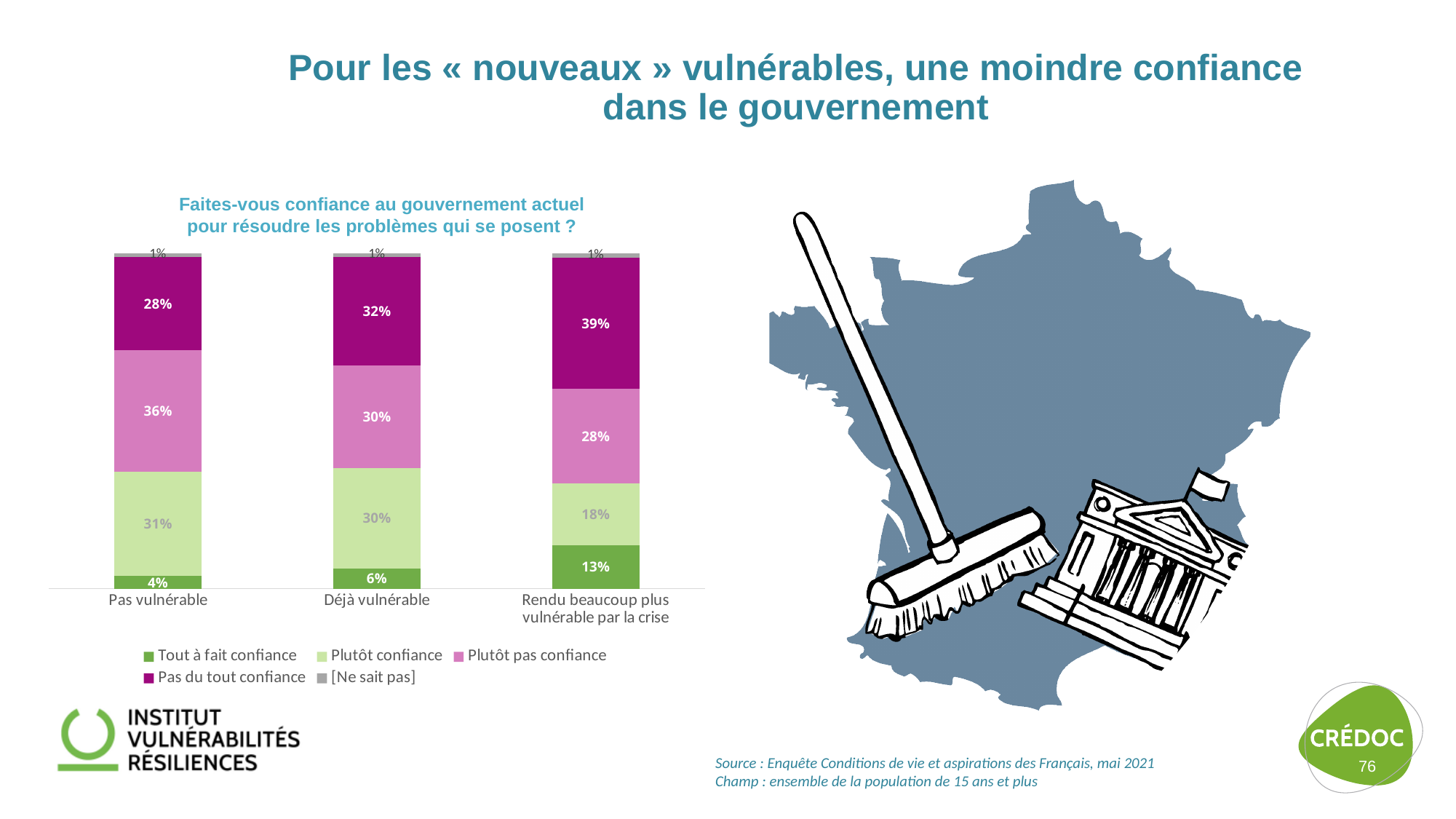
What is the value of 'Plutôt confiance' for 'Rendu beaucoup plus vulnérable par la crise'? 18% Which category has the highest value for 'Pas du tout confiance'? Rendu beaucoup plus vulnérable par la crise What kind of chart is shown on the slide? Stacked bar chart How many series does the legend list? 5 What is the value of 'Tout à fait confiance' for 'Pas vulnérable'? 4% What question is shown as the title of the chart? Faites-vous confiance au gouvernement actuel pour résoudre les problèmes qui se posent ? What is the difference between the 'Pas du tout confiance' values for 'Rendu beaucoup plus vulnérable par la crise' and 'Pas vulnérable'? 11% Which is larger: 'Plutôt confiance' for 'Pas vulnérable' or 'Plutôt confiance' for 'Rendu beaucoup plus vulnérable par la crise'? Pas vulnérable How many categories are shown on the x axis? 3 Which category has the lowest value for 'Tout à fait confiance'? Pas vulnérable What is the value of 'Pas du tout confiance' for 'Rendu beaucoup plus vulnérable par la crise'? 39% What is the value of 'Plutôt pas confiance' for 'Déjà vulnérable'? 30%